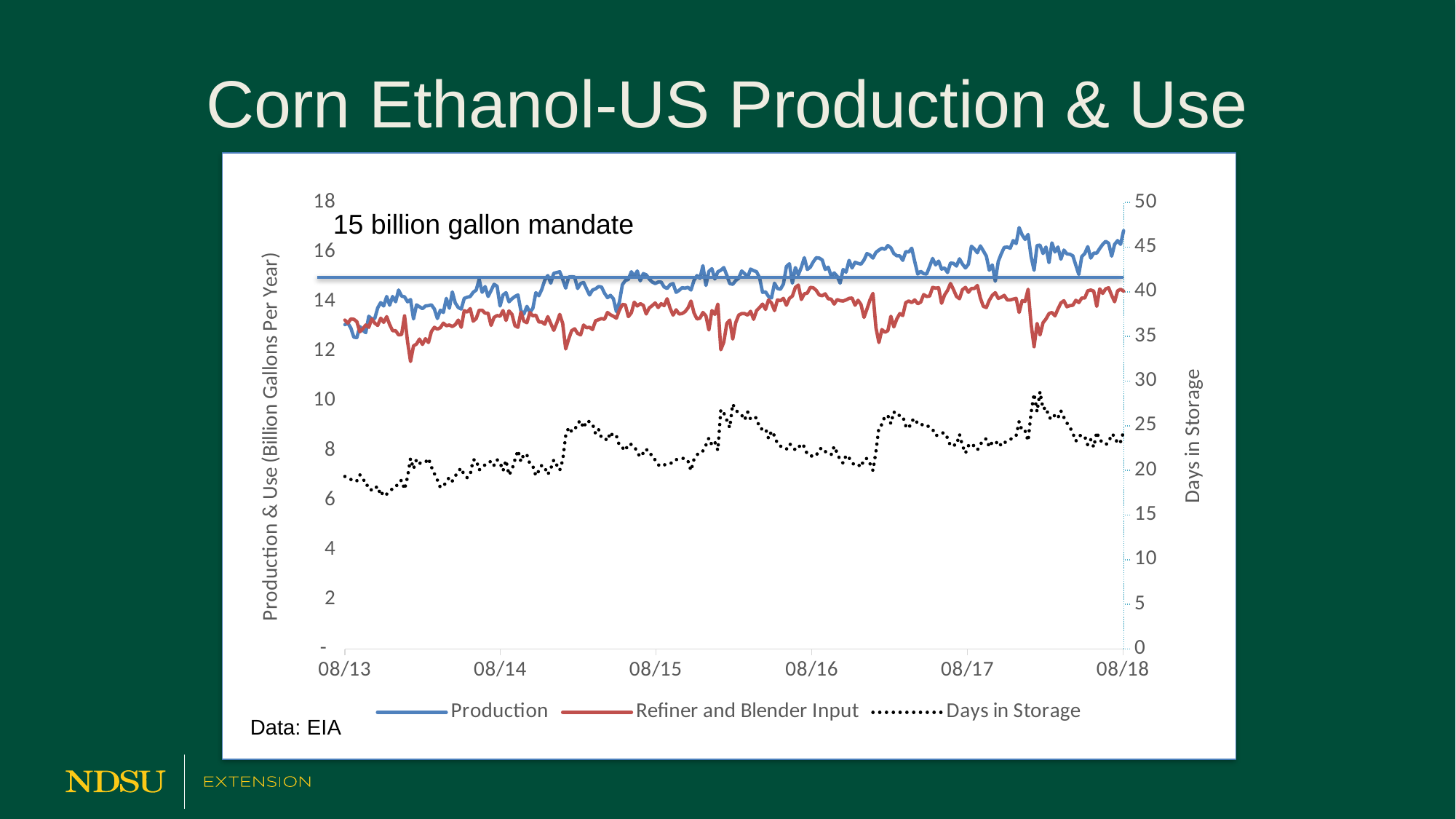
Is the value for Refiner and Blender Input at 08/18 greater or less than 16? less What is the label of the right-hand vertical axis? Days in Storage Is the value for Production at 08/13 greater or less than 14? less Does the Production series generally rise or fall from 08/13 to 08/18? rise How many series does the legend list? 3 Is the value for Production at 08/18 greater or less than 16? greater At 08/18, which is larger: Production or Refiner and Blender Input? Production What kind of chart is shown on the slide? line chart How many date labels are shown on the x axis? 6 What is the title of the slide's chart? Corn Ethanol-US Production & Use